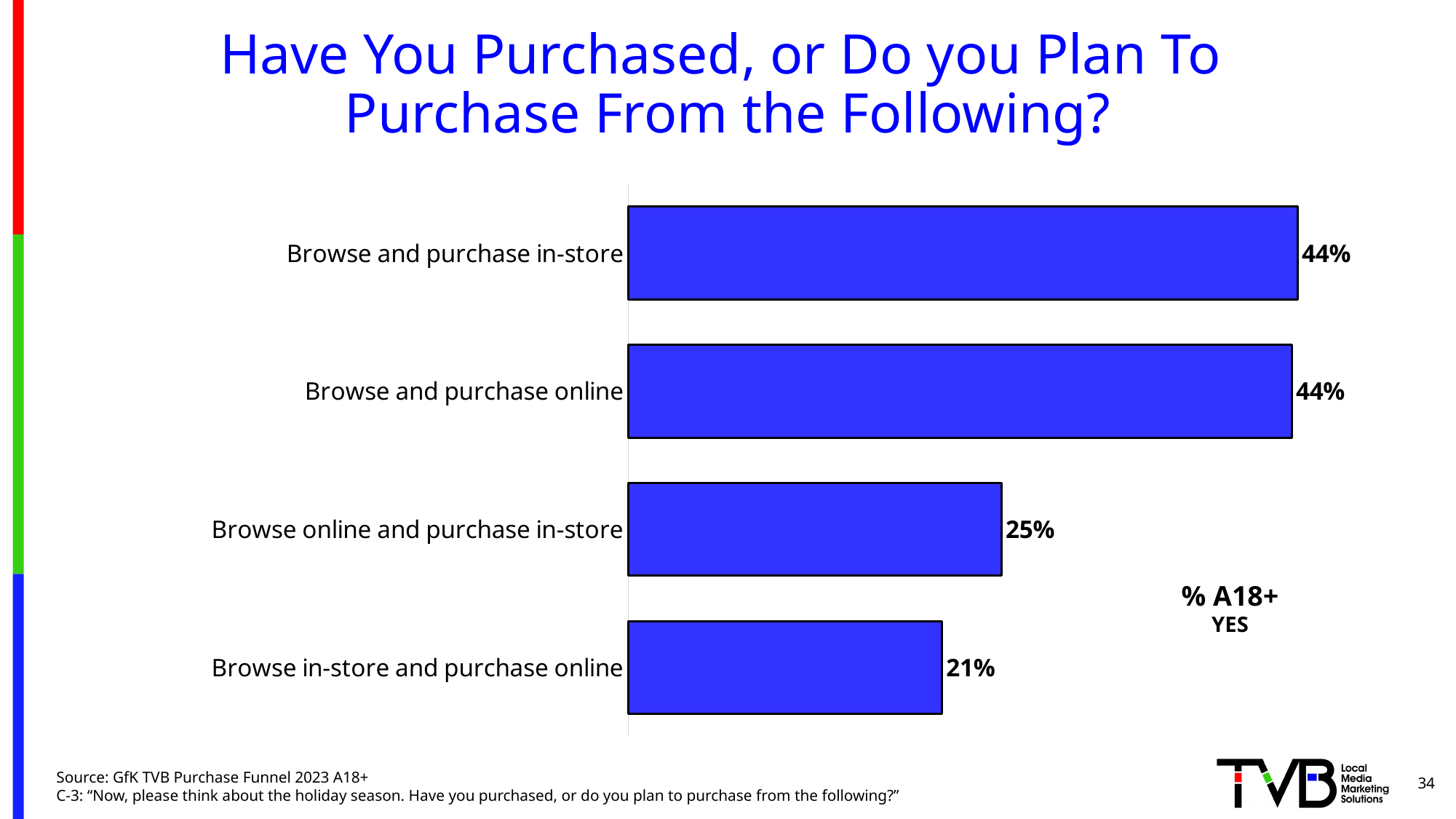
What is the value for "Browse online and purchase in-store"? 25% What is the difference between "Browse and purchase online" and "Browse online and purchase in-store"? 19% What percentage of A18+ said yes to "Browse and purchase in-store"? 44% How many categories are shown in the chart? 4 What is the value for "Browse and purchase online"? 44% What is the difference between "Browse online and purchase in-store" and "Browse in-store and purchase online"? 4% Which category has the lowest value? Browse in-store and purchase online What kind of chart is shown on the slide? Bar chart Do the values rise or fall going from the top bar to the bottom bar? Fall What is the title of the chart on the slide? Have You Purchased, or Do you Plan To Purchase From the Following? What is the value for "Browse in-store and purchase online"? 21% Which is larger: "Browse and purchase in-store" or "Browse in-store and purchase online"? Browse and purchase in-store